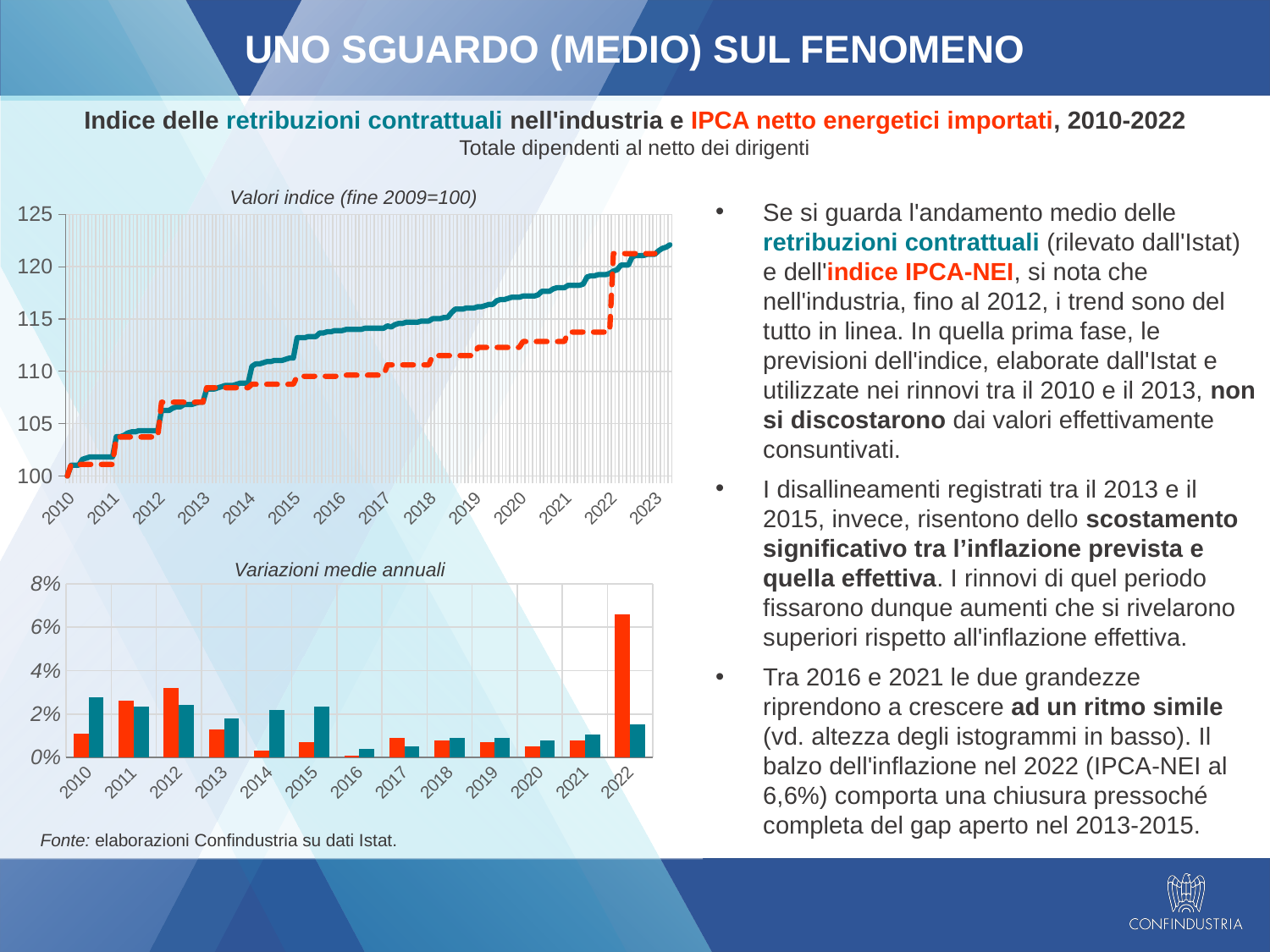
In the bottom chart 'Variazioni medie annuali', which year has the highest red bar? 2022 What kind of chart is the bottom chart titled 'Variazioni medie annuali'? bar chart In the top chart 'Valori indice (fine 2009=100)', is the value of the teal line at 2016 greater or less than 110? greater In the bottom chart 'Variazioni medie annuali', which is larger in 2012, the teal bar or the red bar? the red bar In the top chart 'Valori indice (fine 2009=100)', is the value of the red dashed IPCA line at 2020 greater or less than 115? less How many years are shown on the x axis of the bottom chart 'Variazioni medie annuali'? 13 In the top chart 'Valori indice (fine 2009=100)', do the values rise or fall from 2010 to 2023? rise In the bottom chart 'Variazioni medie annuali', which is larger in 2014, the teal bar or the red bar? the teal bar In the top chart 'Valori indice (fine 2009=100)', is the value of the teal retribuzioni contrattuali line at 2023 greater or less than 120? greater What kind of chart is the top chart titled 'Valori indice (fine 2009=100)'? line chart According to the note below the charts, what is the source of the data? elaborazioni Confindustria su dati Istat